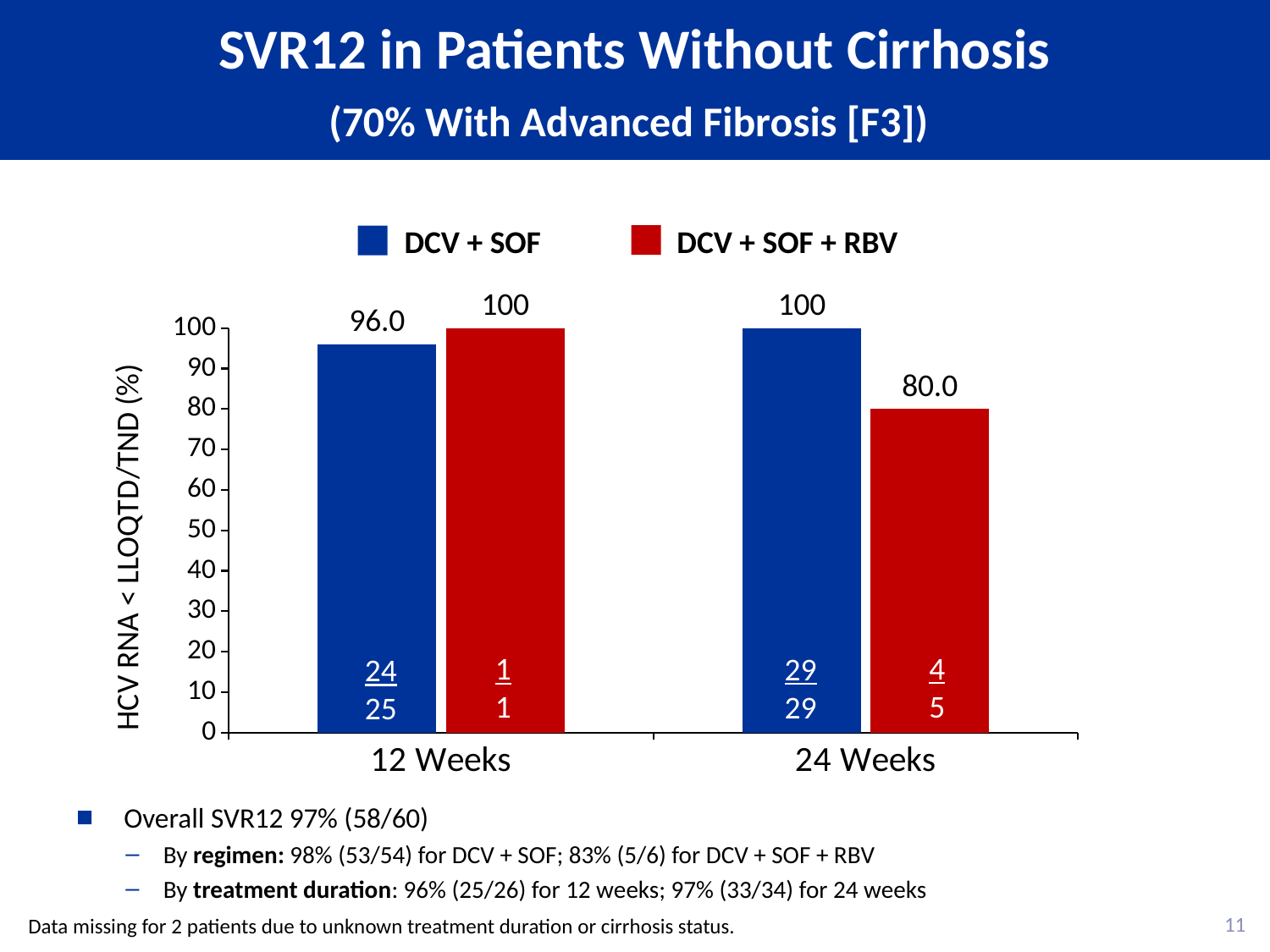
How many treatment duration categories are shown on the x axis? 2 What kind of chart is shown on the slide? Bar chart What is the SVR12 value for DCV + SOF at 24 weeks? 100 What is the SVR12 value for DCV + SOF at 12 weeks? 96.0 What is the SVR12 value for DCV + SOF + RBV at 12 weeks? 100 At 24 weeks, which regimen has the higher SVR12 value, DCV + SOF or DCV + SOF + RBV? DCV + SOF How many series does the legend list? 2 What is the difference between the DCV + SOF and DCV + SOF + RBV values at 24 weeks? 20.0 What is the label of the y axis? HCV RNA < LLOQTD/TND (%) What is the SVR12 value for DCV + SOF + RBV at 24 weeks? 80.0 Which bar has the lowest value on the chart? DCV + SOF + RBV at 24 weeks What is the difference between the DCV + SOF + RBV and DCV + SOF values at 12 weeks? 4.0